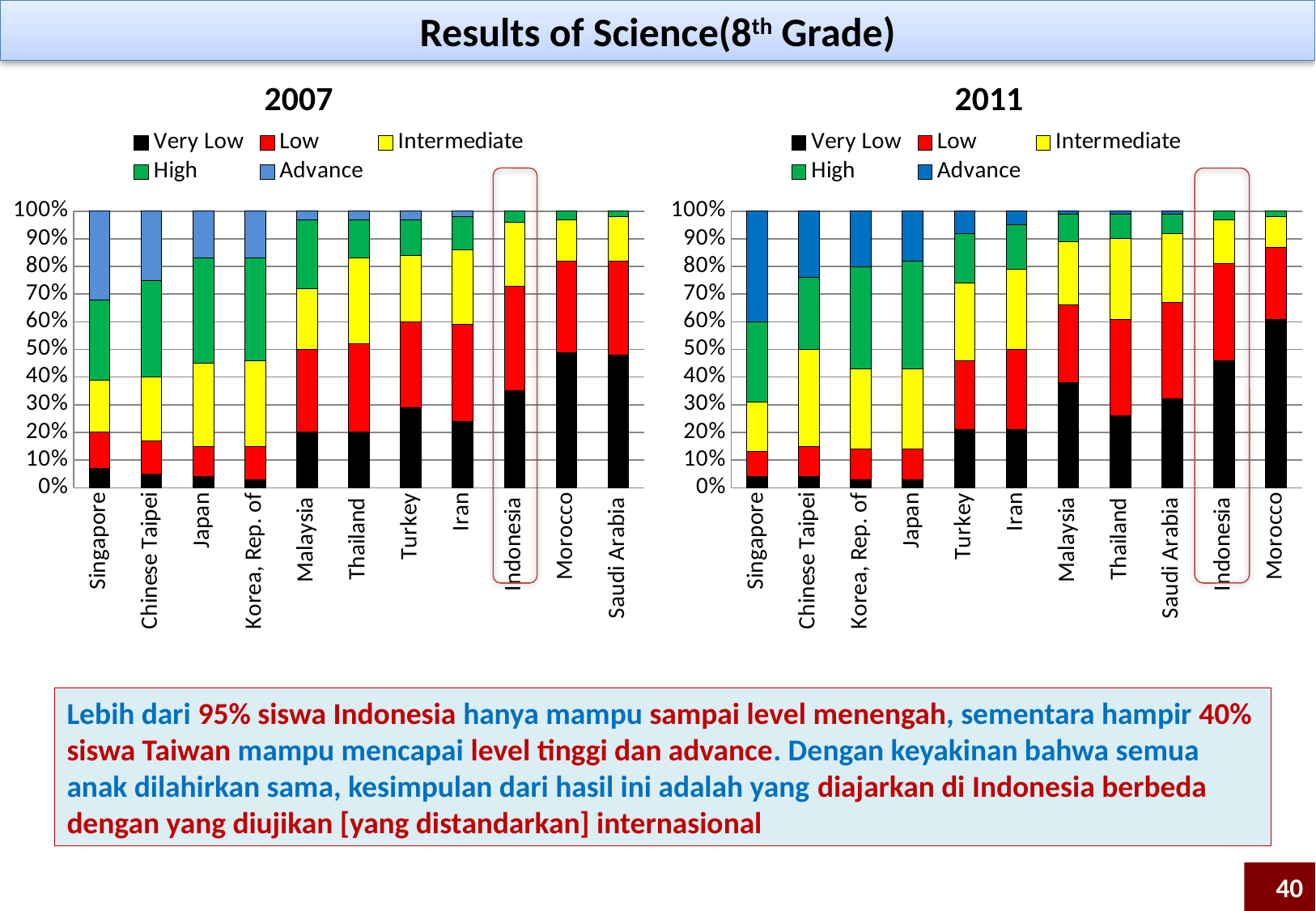
On the 2007 chart, which has the larger Very Low share, Indonesia or Turkey? Indonesia What kind of chart is the 2007 chart? stacked bar chart On the 2011 chart, which country has the highest Very Low share? Morocco On the 2007 chart, is the Very Low value for Singapore greater or less than 10%? less On the 2011 chart, is the Very Low value for Singapore greater or less than 10%? less How many countries are shown on the 2007 chart? 11 Which country is highlighted with a red outline on both charts? Indonesia How many countries are shown on the 2011 chart? 11 On the 2011 chart, which has the larger Very Low share, Indonesia or Malaysia? Indonesia On the 2007 chart, is the Very Low value for Morocco greater or less than 40%? greater How many series does the legend of the 2011 chart list? 5